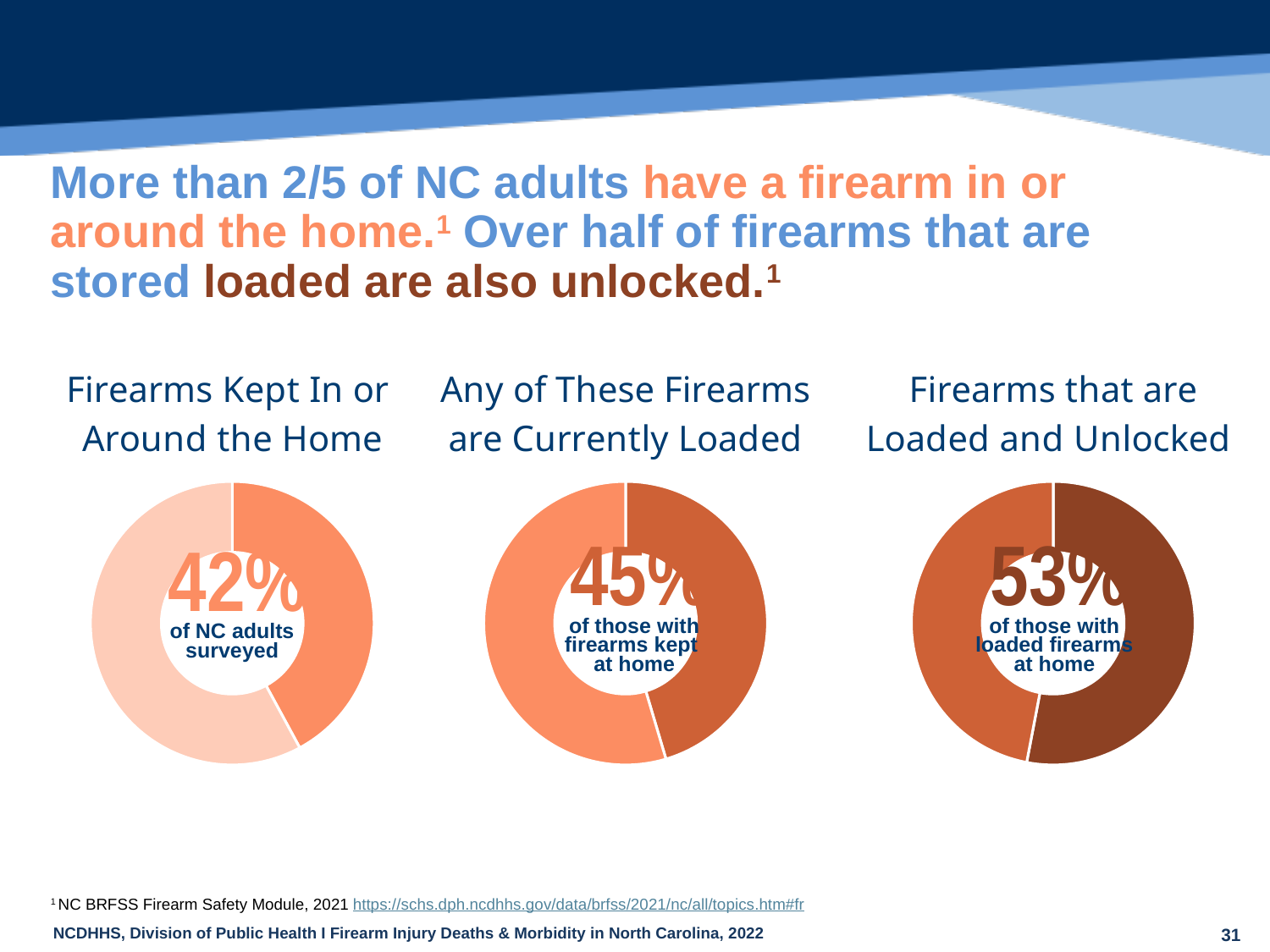
Is the percentage in the 'Firearms that are Loaded and Unlocked' chart greater or less than 50%? greater Which of the three charts shows the lowest percentage? Firearms Kept In or Around the Home Is the percentage in the 'Any of These Firearms are Currently Loaded' chart larger or smaller than the percentage in the 'Firearms that are Loaded and Unlocked' chart? Smaller Which of the three charts shows the highest percentage? Firearms that are Loaded and Unlocked What is the difference between the percentage in the 'Firearms that are Loaded and Unlocked' chart and the 'Firearms Kept In or Around the Home' chart? 11% What kind of chart is used for 'Firearms Kept In or Around the Home'? Donut chart In the 'Firearms that are Loaded and Unlocked' chart, what group does the 53% refer to? Those with loaded firearms at home How many donut charts are on the slide? 3 In the 'Firearms Kept In or Around the Home' chart, what group does the 42% refer to? NC adults surveyed What percentage is shown in the 'Any of These Firearms are Currently Loaded' chart? 45% What percentage is shown in the 'Firearms that are Loaded and Unlocked' chart? 53% What percentage is shown in the 'Firearms Kept In or Around the Home' chart? 42%